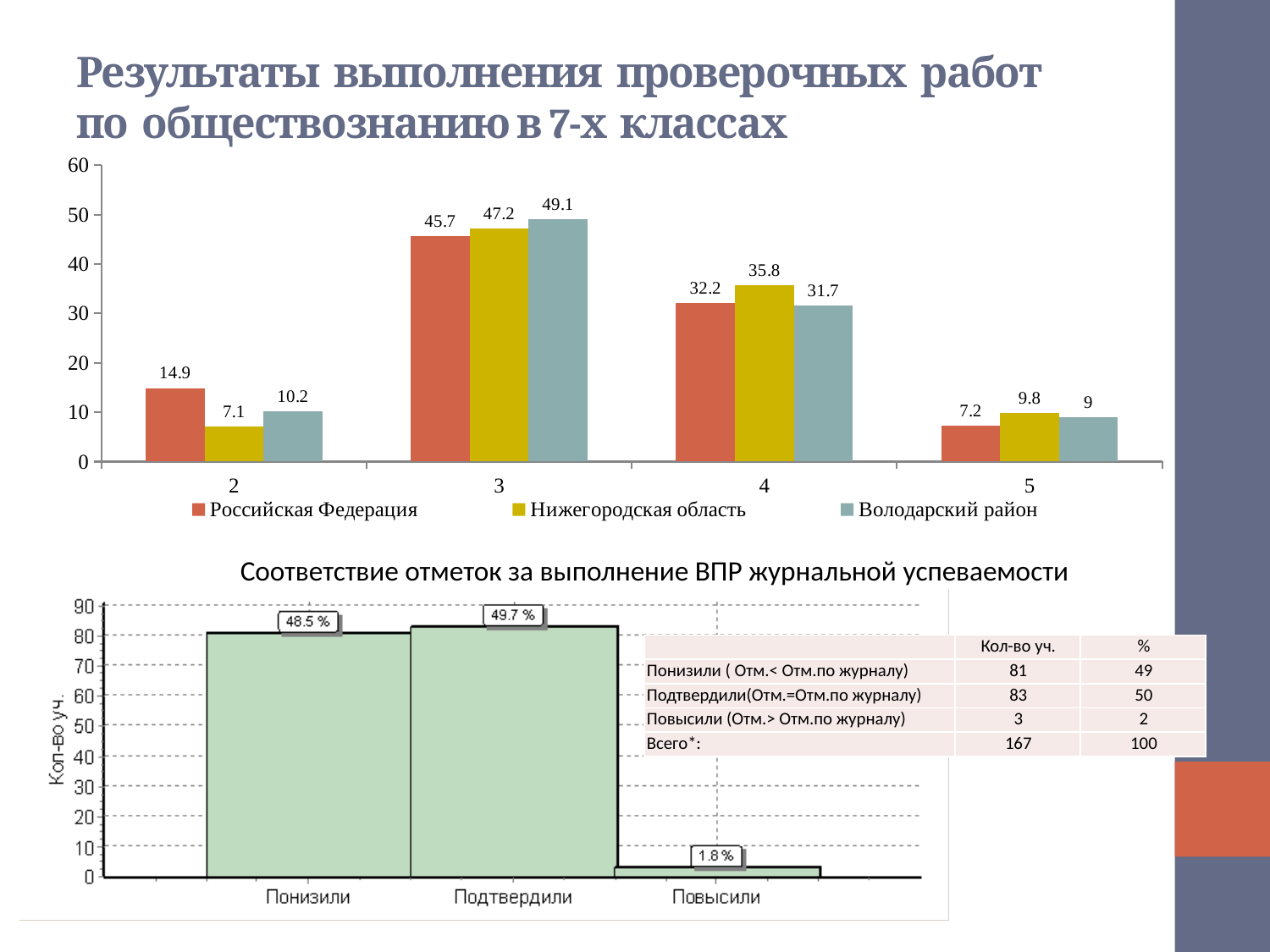
In the top chart, which category has the highest value for Володарский район? 3 In the top chart, what is the value for Нижегородская область at category 5? 9.8 In the top chart, which category has the lowest value for Российская Федерация? 5 What type of chart is the bottom chart 'Соответствие отметок за выполнение ВПР журнальной успеваемости'? bar chart In the bottom chart 'Соответствие отметок за выполнение ВПР журнальной успеваемости', which category has the lowest bar? Повысили In the top chart, at category 2, which is larger: Российская Федерация or Нижегородская область? Российская Федерация In the top chart, what is the value for Володарский район at category 2? 10.2 In the top chart, what is the value for Российская Федерация at category 3? 45.7 In the top chart, what is the difference between Нижегородская область and Российская Федерация at category 4? 3.6 How many categories are shown on the x axis of the top chart? 4 In the bottom chart 'Соответствие отметок за выполнение ВПР журнальной успеваемости', what percentage label is shown for Подтвердили? 49.7 % How many series does the legend of the top chart list? 3